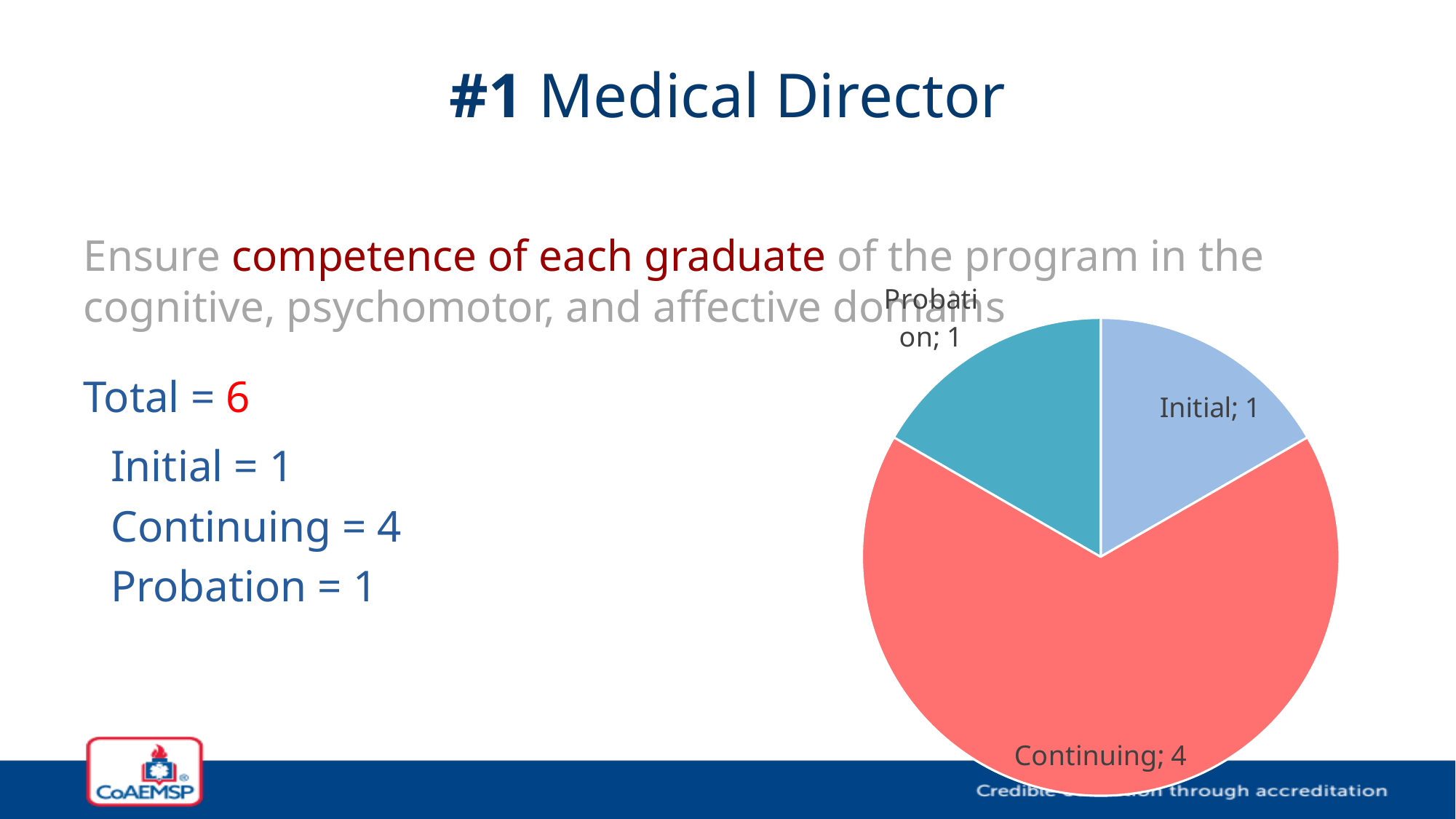
Which is larger, the Continuing slice or the Probation slice? Continuing How many slices does the pie chart have? 3 What colour is the Probation slice? teal What share of the pie does the Continuing slice represent? 4 of 6 (two thirds) Which category has the largest slice in the pie chart? Continuing What is the value for Continuing in the pie chart? 4 What is the value for Probation in the pie chart? 1 What is the total of all slices in the pie chart? 6 What kind of chart is shown on the slide? pie chart What is the value for Initial in the pie chart? 1 What colour is the Continuing slice? red What is the difference between the Continuing and Initial values? 3